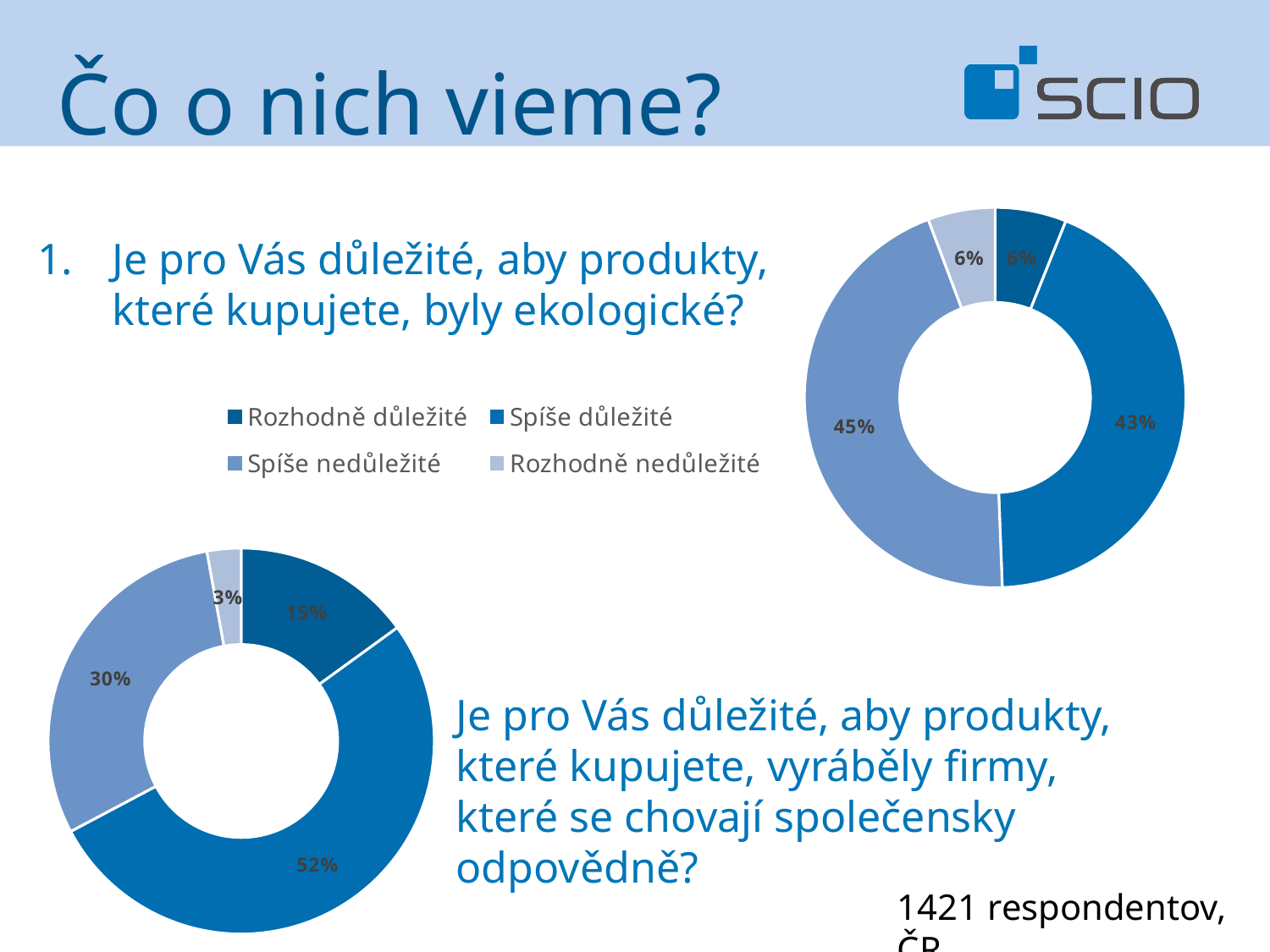
In the bottom-left doughnut chart, which answer has the largest share? Spíše důležité In the top-right doughnut chart, what is the difference in percentage points between "Spíše nedůležité" and "Spíše důležité"? 2 percentage points In the bottom-left doughnut chart, what is the difference in percentage points between "Spíše důležité" and "Spíše nedůležité"? 22 percentage points Which chart has the larger share for "Rozhodně důležité", the top-right chart or the bottom-left chart? The bottom-left chart In the bottom-left doughnut chart, what share of respondents answered "Rozhodně důležité"? 15% How many answer categories does the legend list? 4 In the bottom-left doughnut chart, what share of respondents answered "Spíše důležité"? 52% In the bottom-left doughnut chart, which answer has the smallest share? Rozhodně nedůležité In the bottom-left doughnut chart, what share of respondents answered "Rozhodně nedůležité"? 3% In the top-right doughnut chart, what share of respondents answered "Spíše nedůležité"? 45% In the top-right doughnut chart, what share of respondents answered "Spíše důležité"? 43% What type of chart is used on this slide? Doughnut (pie) chart